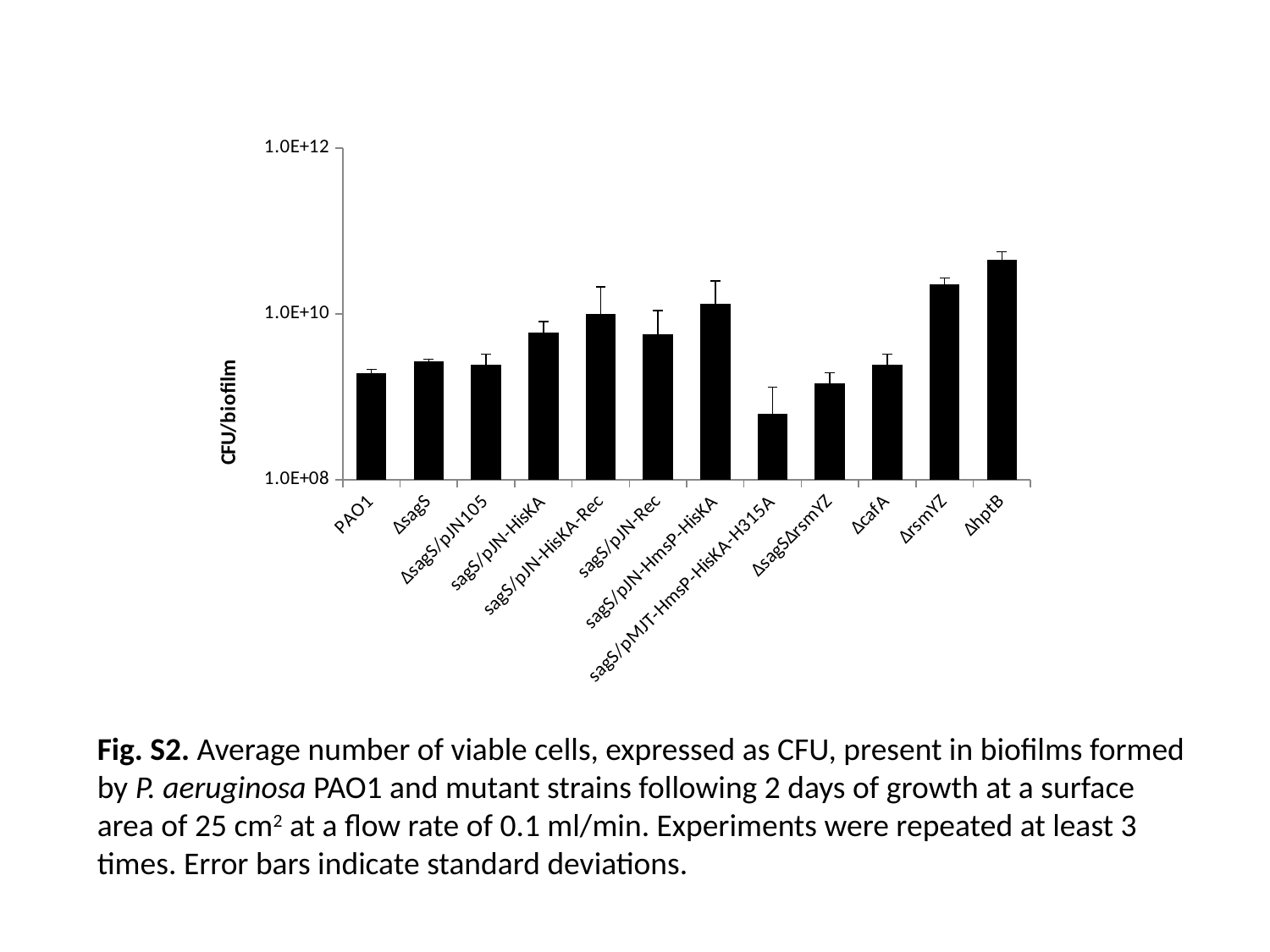
Is the value for PAO1 greater or less than 1.0E+10? less What is the label on the y-axis of the chart? CFU/biofilm Is the value for sagS/pMJT-HmsP-HisKA-H315A greater or less than 1.0E+10? less Which strain has the highest CFU/biofilm value? ΔhptB Which has a larger CFU/biofilm value, ΔhptB or PAO1? ΔhptB Is the value for ΔrsmYZ greater or less than 1.0E+10? greater Which has a larger CFU/biofilm value, ΔrsmYZ or ΔcafA? ΔrsmYZ Which strain has the lowest CFU/biofilm value? sagS/pMJT-HmsP-HisKA-H315A How many strains (bars) are plotted in the chart? 12 What is the highest tick value shown on the y-axis? 1.0E+12 What kind of chart is shown on the slide? bar chart